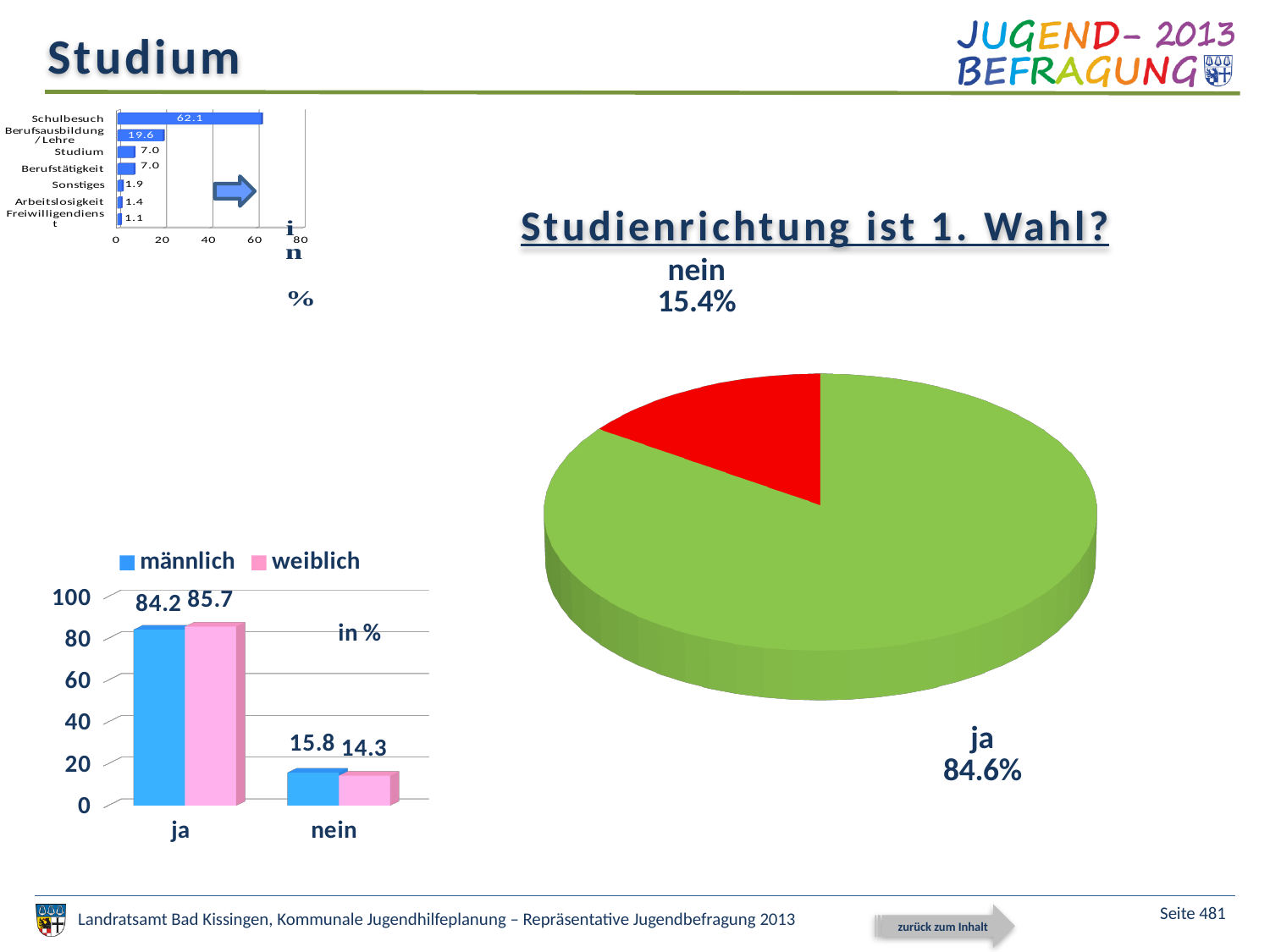
In the bar chart at the top left of the slide, which category has the lowest value? Freiwilligendienst In the pie chart titled "Studienrichtung ist 1. Wahl?", what colour is the "nein" slice? red In the pie chart titled "Studienrichtung ist 1. Wahl?", what share is labelled "nein"? 15.4% In the bar chart at the bottom left of the slide, how many series does the legend list? 2 In the bar chart at the bottom left of the slide, what kind of chart is it? bar chart In the bar chart at the bottom left of the slide, what is the value for "weiblich" in the "nein" category? 14.3 In the pie chart titled "Studienrichtung ist 1. Wahl?", which slice is larger, "ja" or "nein"? ja In the bar chart at the top left of the slide, how many categories are shown? 7 In the bar chart at the bottom left of the slide, what is the value for "männlich" in the "ja" category? 84.2 In the bar chart at the bottom left of the slide, what is the difference between the "weiblich" and "männlich" values in the "ja" category? 1.5 In the pie chart titled "Studienrichtung ist 1. Wahl?", what share is labelled "ja"? 84.6% In the bar chart at the top left of the slide, what is the value for "Schulbesuch"? 62.1